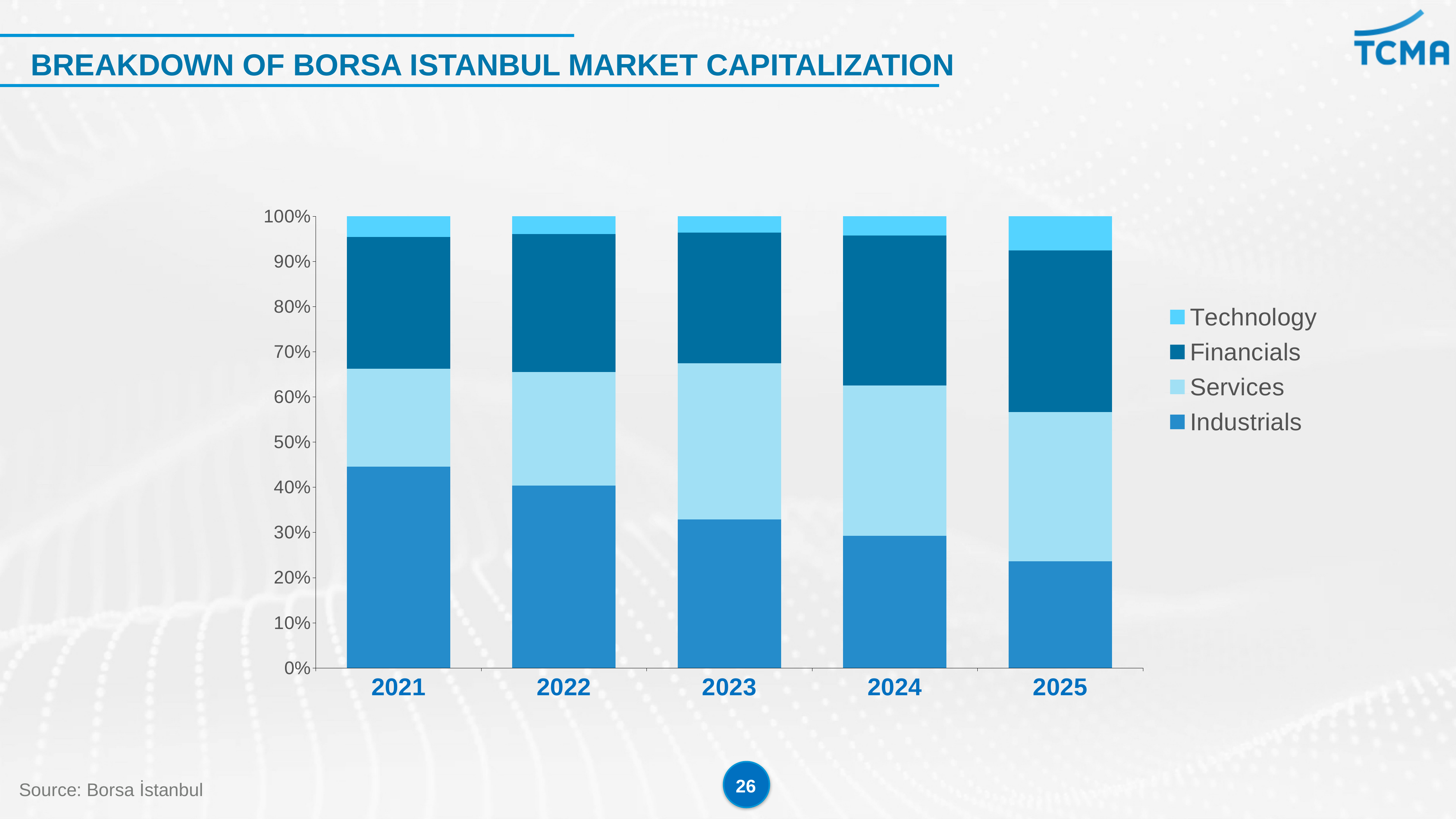
How many years are shown on the x axis of the chart? 5 Is the Industrials share for 2023 greater or less than 30%? greater What kind of chart is shown on the slide? Stacked bar chart Which series is listed first in the chart's legend? Technology In which year is the Industrials share the lowest? 2025 How many series does the chart's legend list? 4 Is the Industrials share for 2022 greater or less than 50%? less In which year is the Industrials share the highest? 2021 Does the Industrials share rise or fall from 2021 to 2025? fall What is the title of the chart on the slide? Breakdown of Borsa Istanbul Market Capitalization Is the Industrials share for 2021 greater or less than 40%? greater